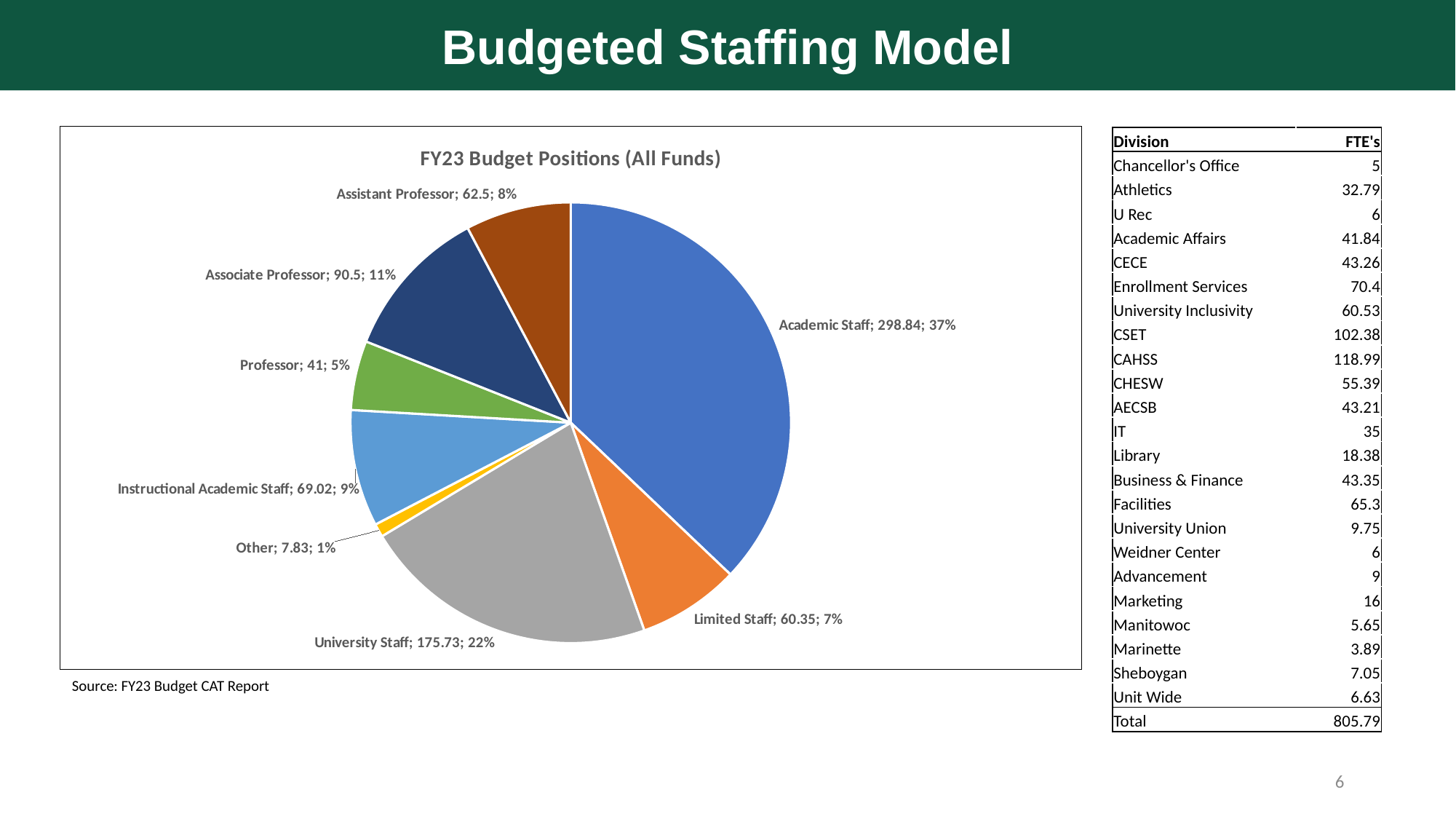
What is the value for Instructional Academic Staff? 69.02 What is the value for University Staff? 175.73 How many categories are shown in the pie chart? 8 What type of chart is shown on the slide? pie chart What share of the pie does Associate Professor represent? 11% Which category has the smallest slice? Other What is the value for Academic Staff? 298.84 Which is larger, the value for Professor or the value for Limited Staff? Limited Staff What is the difference between the values for Associate Professor and Assistant Professor? 28 Which category has the largest slice? Academic Staff What is the title of the chart? FY23 Budget Positions (All Funds) What share of the pie does Limited Staff represent? 7%